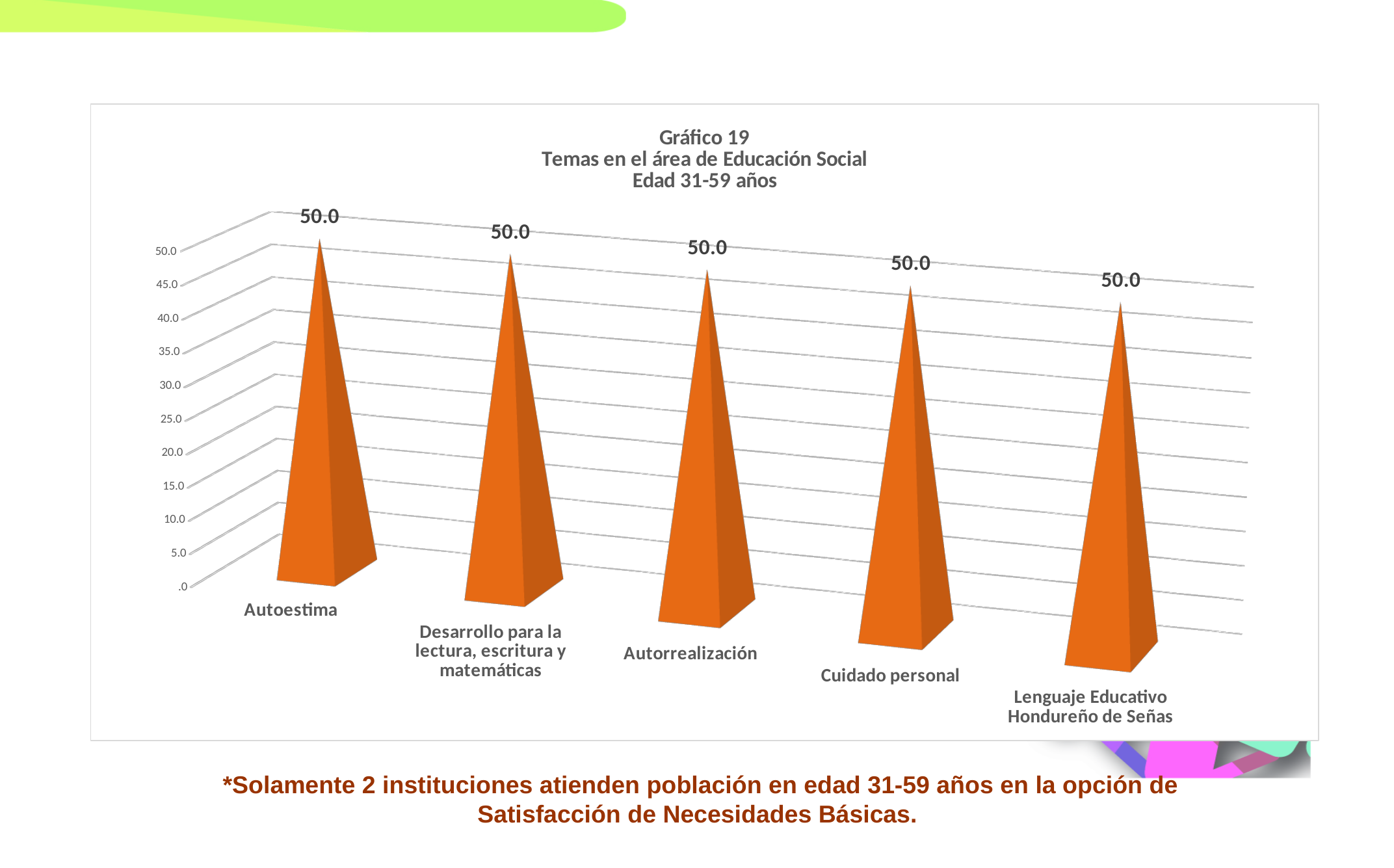
What is the value for Cuidado personal? 50.0 What is the difference between the values for Autoestima and Cuidado personal? 0.0 What colour are the bars in the chart? orange Is the value for Autorrealización greater or less than 40.0? greater What is the title of the chart? Gráfico 19 Temas en el área de Educación Social Edad 31-59 años Do the values rise, fall, or stay the same across the categories? stay the same What is the value for Desarrollo para la lectura, escritura y matemáticas? 50.0 What is the value for Autoestima? 50.0 What is the value for Lenguaje Educativo Hondureño de Señas? 50.0 How many categories are shown on the x axis? 5 What is the value for Autorrealización? 50.0 What kind of chart is this? bar chart